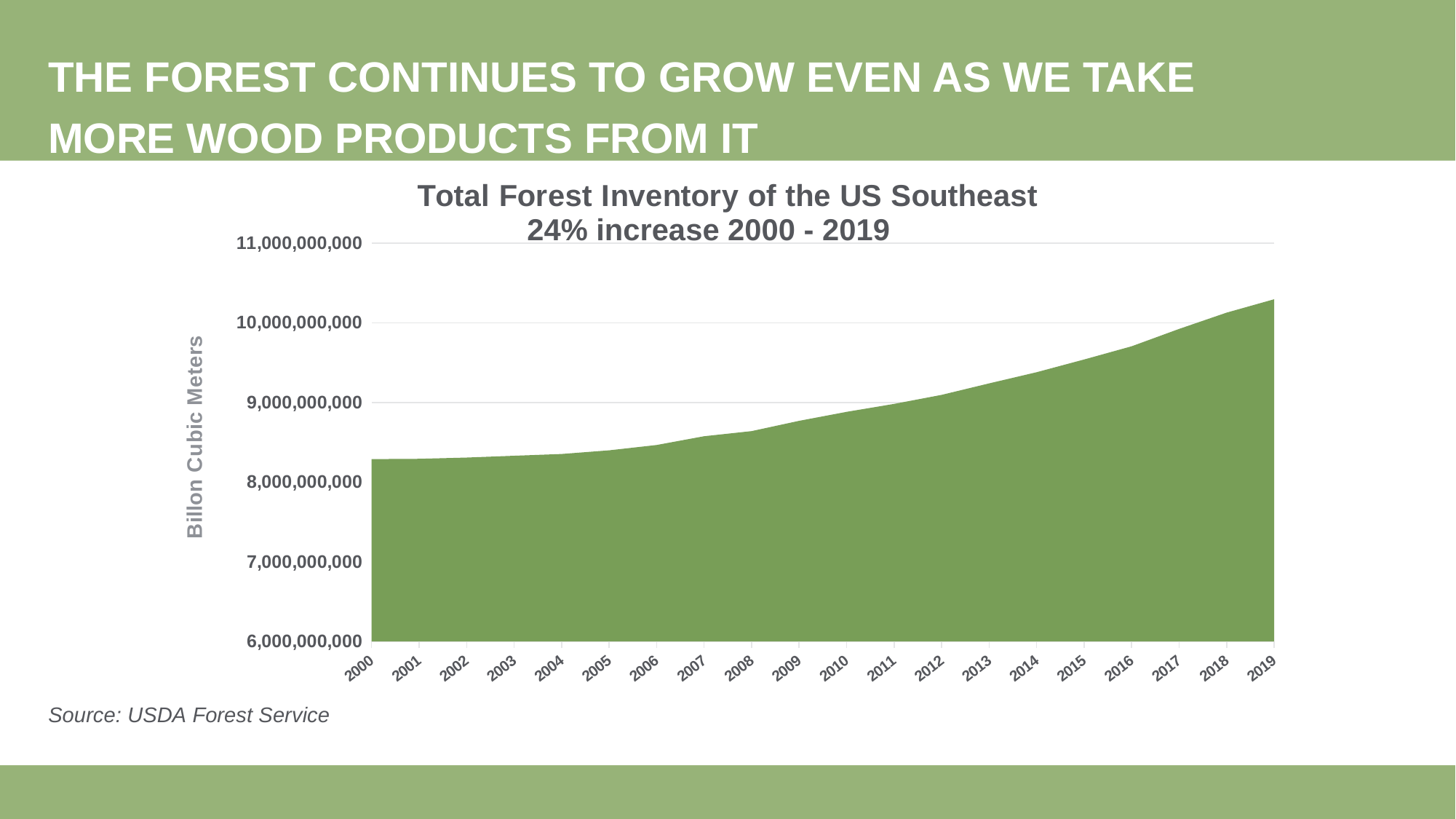
Is the value for 2005 greater or less than 8,000,000,000? greater What is the title of the chart? Total Forest Inventory of the US Southeast 24% increase 2000 - 2019 Is the value for 2015 greater or less than 9,000,000,000? greater How many years are plotted along the x axis of the chart? 20 What kind of chart is shown on the slide? Area chart Is the value for 2019 greater or less than 10,000,000,000? greater Do the values in the chart rise or fall from 2000 to 2019? Rise Which year has the lowest forest inventory value in the chart? 2000 Which year has the highest forest inventory value in the chart? 2019 Which year has the larger forest inventory value, 2000 or 2019? 2019 What is the label on the vertical axis of the chart? Billon Cubic Meters